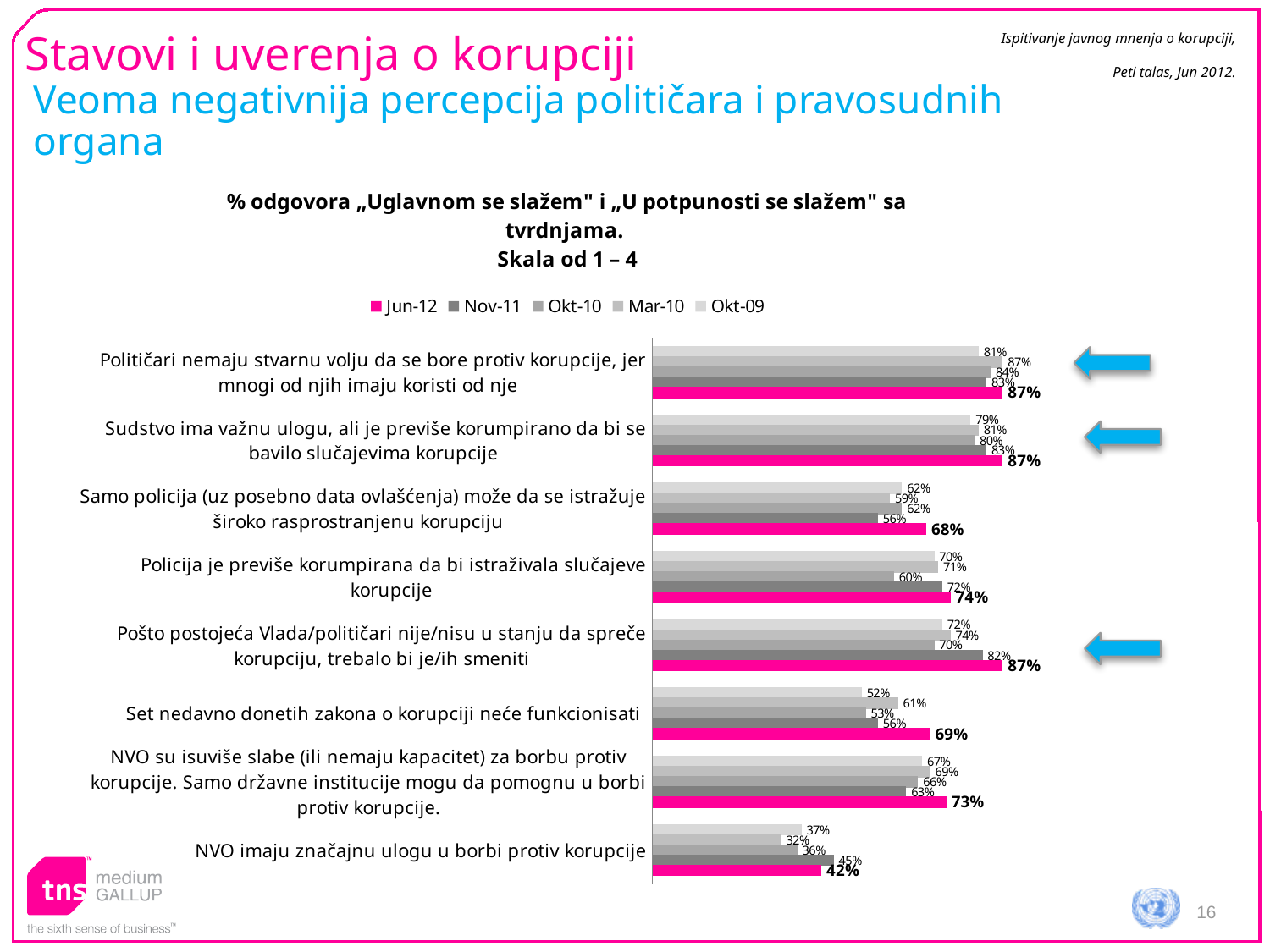
What is the difference between the Jun-12 values for "Samo policija (uz posebno data ovlašćenja) može da se istražuje široko rasprostranjenu korupciju" and "NVO imaju značajnu ulogu u borbi protiv korupcije"? 26 percentage points What is the Nov-11 value for "Pošto postojeća Vlada/političari nije/nisu u stanju da spreče korupciju, trebalo bi je/ih smeniti"? 82% How many series does the legend list? 5 What is the first line of the chart title? % odgovora „Uglavnom se slažem" i „U potpunosti se slažem" sa For Jun-12, which is larger: the value for "Set nedavno donetih zakona o korupciji neće funkcionisati" or for "NVO su isuviše slabe (ili nemaju kapacitet) za borbu protiv korupcije..."? NVO su isuviše slabe (ili nemaju kapacitet) za borbu protiv korupcije... What is the Jun-12 value for "Sudstvo ima važnu ulogu, ali je previše korumpirano da bi se bavilo slučajevima korupcije"? 87% Which series is shown in pink in the chart? Jun-12 What is the Jun-12 value for "Samo policija (uz posebno data ovlašćenja) može da se istražuje široko rasprostranjenu korupciju"? 68% What kind of chart is shown on the slide? bar chart What is the Jun-12 value for "NVO imaju značajnu ulogu u borbi protiv korupcije"? 42% Which statement has the lowest Jun-12 value? NVO imaju značajnu ulogu u borbi protiv korupcije How many statements (categories) are plotted in the chart? 8